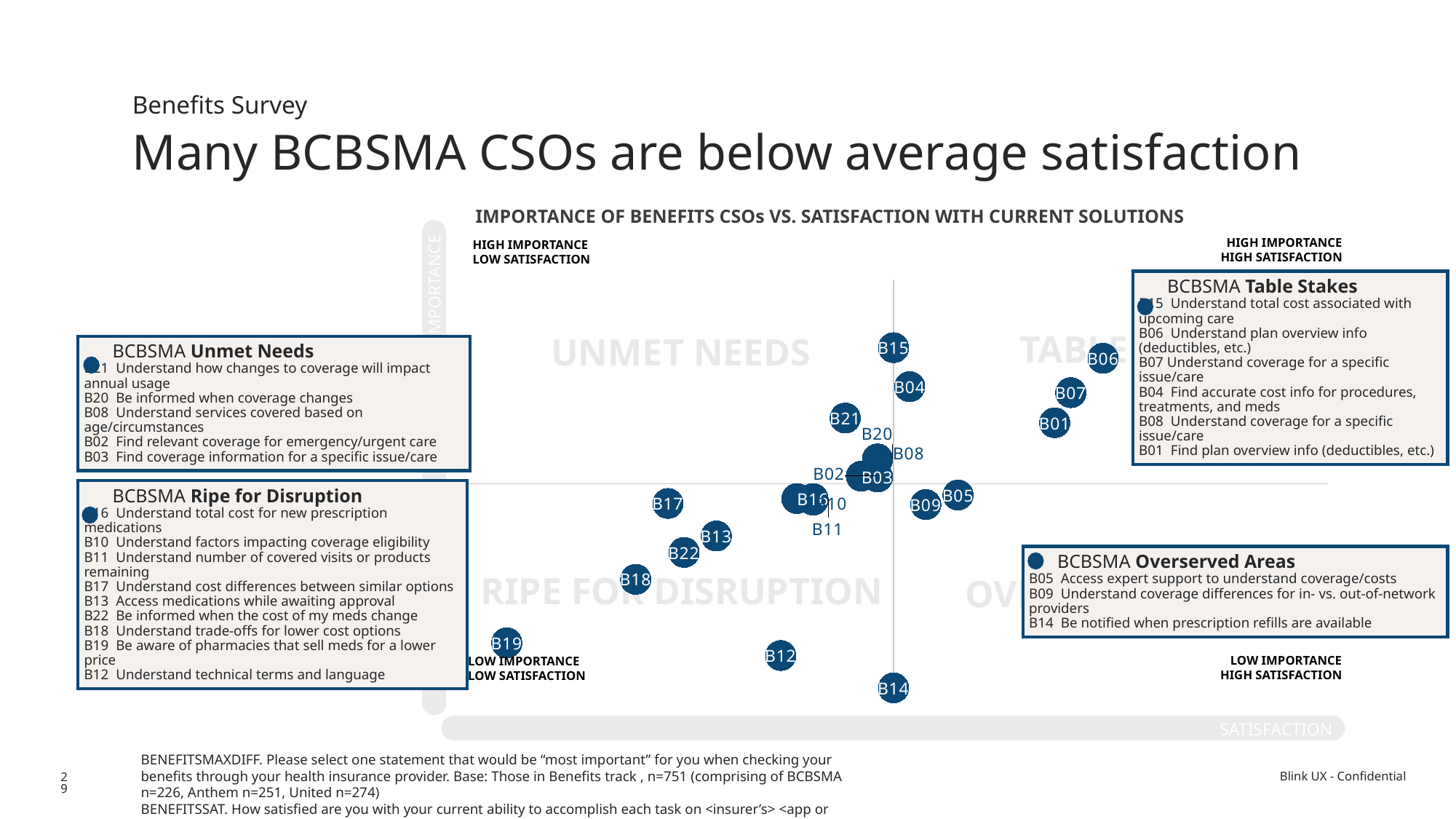
In which quadrant does point B12 fall? Ripe for Disruption In which quadrant does point B06 fall? Table Stakes What kind of chart is shown on the slide? Scatter plot How many data points (CSOs) are plotted on the chart? 22 Which has higher importance, B21 or B18? B21 Which point has the lowest satisfaction (is furthest left on the horizontal axis)? B19 What does the horizontal axis of the chart represent? Satisfaction Which has higher satisfaction, B19 or B12? B12 Which has higher importance, B04 or B13? B04 Which point has the lowest importance (is lowest on the vertical axis)? B14 What is the title of the chart? IMPORTANCE OF BENEFITS CSOs VS. SATISFACTION WITH CURRENT SOLUTIONS Which point has the highest satisfaction (is furthest right on the horizontal axis)? B06